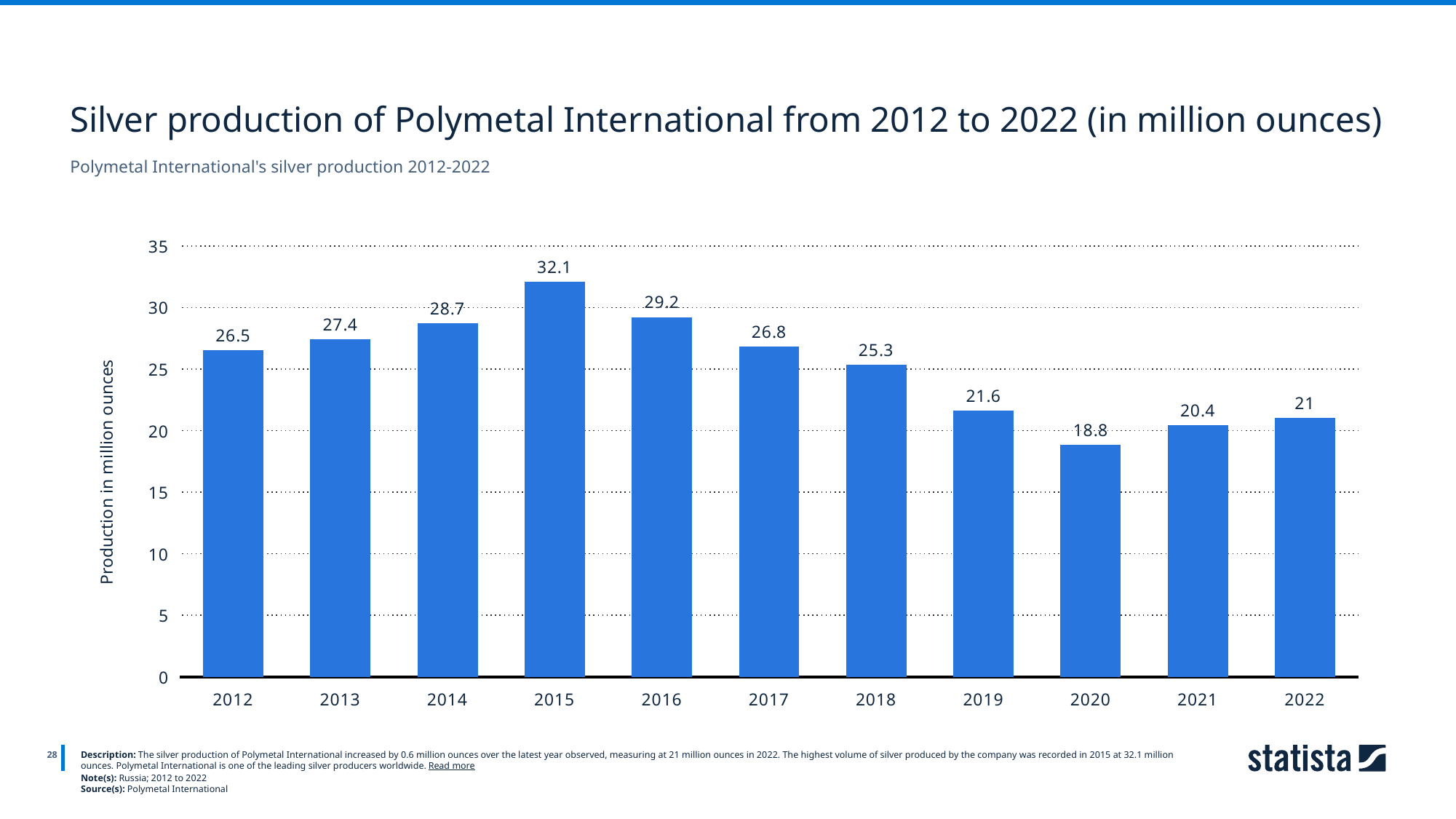
Is the value for 2018 greater or less than 25? greater What is the label of the y-axis? Production in million ounces Which year had the lowest silver production? 2020 What type of chart is shown on the slide? Bar chart What was the silver production in 2022? 21 By how much did silver production change from 2021 to 2022? 0.6 What is the difference in silver production between 2015 and 2020? 13.3 How many years are shown on the chart? 11 What was Polymetal International's silver production in 2015? 32.1 Which year had the highest silver production? 2015 What was the silver production in 2020? 18.8 Which year had higher silver production, 2014 or 2016? 2016